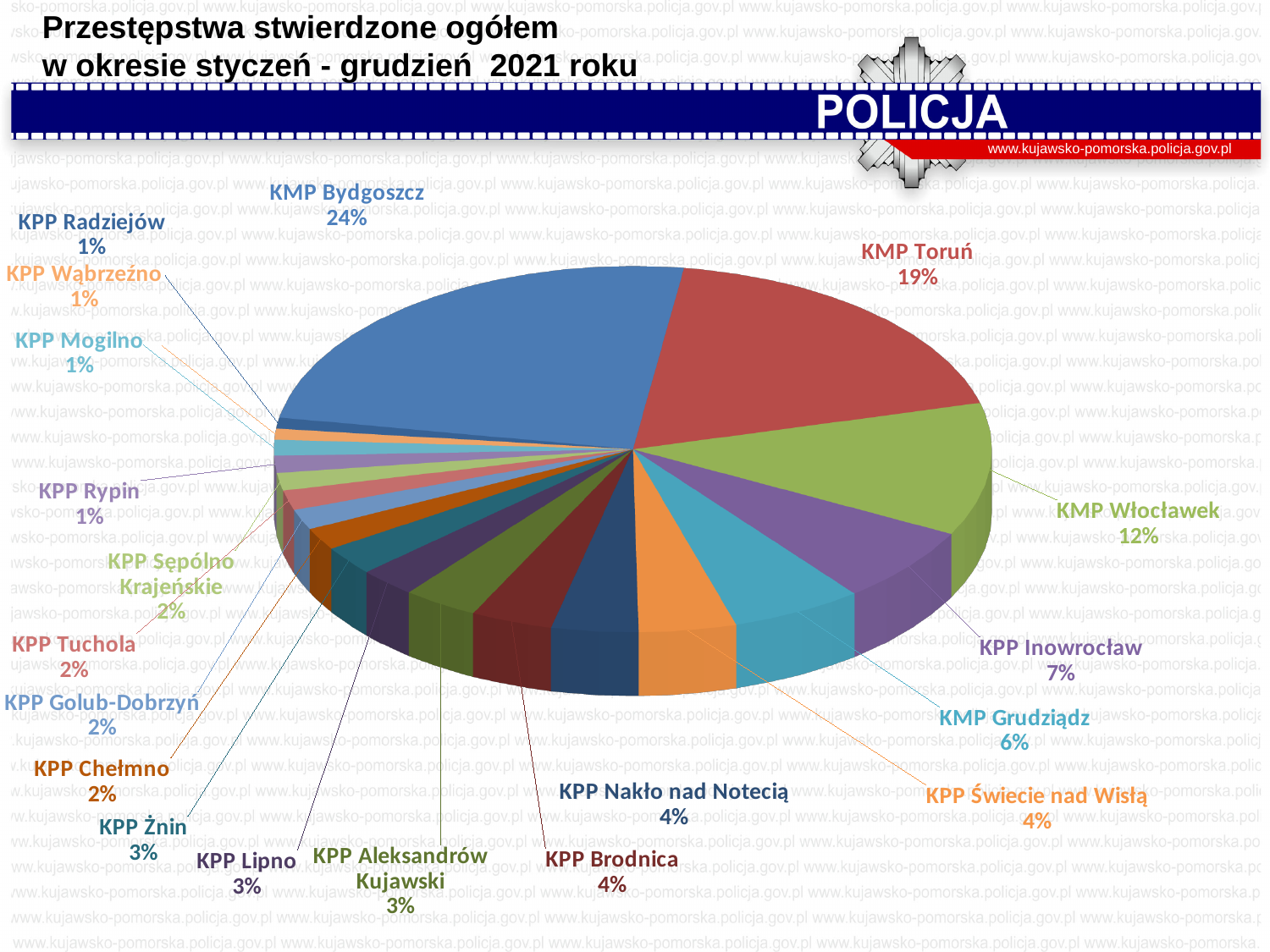
What percentage is shown for KPP Inowrocław? 7% Which unit has the largest share of the pie? KMP Bydgoszcz What percentage is shown for KMP Toruń? 19% How many units (slices) are labelled on the pie chart? 19 What is the difference in percentage points between KMP Bydgoszcz and KMP Toruń? 5 What percentage is shown for KMP Włocławek? 12% What percentage is shown for KMP Grudziądz? 6% What is the title of the slide containing the chart? Przestępstwa stwierdzone ogółem w okresie styczeń - grudzień 2021 roku What share of the pie does KMP Bydgoszcz account for? 24% Which has the larger share, KPP Inowrocław or KMP Grudziądz? KPP Inowrocław What percentage is shown for KPP Żnin? 3% What kind of chart is shown on the slide? pie chart